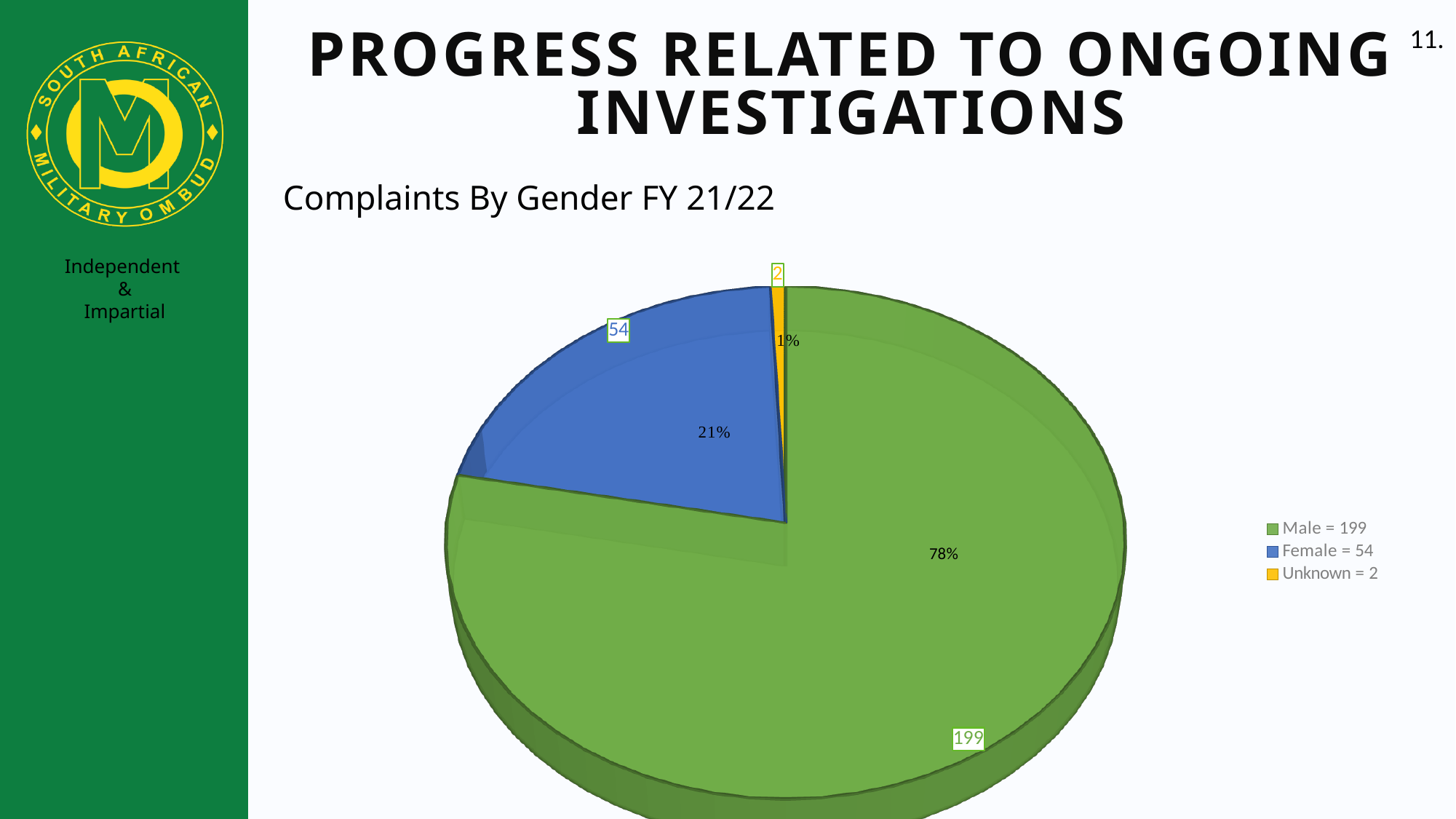
How many complaints are of unknown gender? 2 Which gender category has the smallest share of complaints? Unknown What is the difference between the number of male and female complaints? 145 What colour is the Female slice of the pie chart? Blue How many categories does the pie chart show? 3 What percentage of complaints were from males? 78% What percentage of complaints are of unknown gender? 1% Which gender category has the largest share of complaints? Male How many complaints were from males in FY 21/22? 199 What percentage of complaints were from females? 21% How many complaints were from females in FY 21/22? 54 What kind of chart is shown on the slide? Pie chart